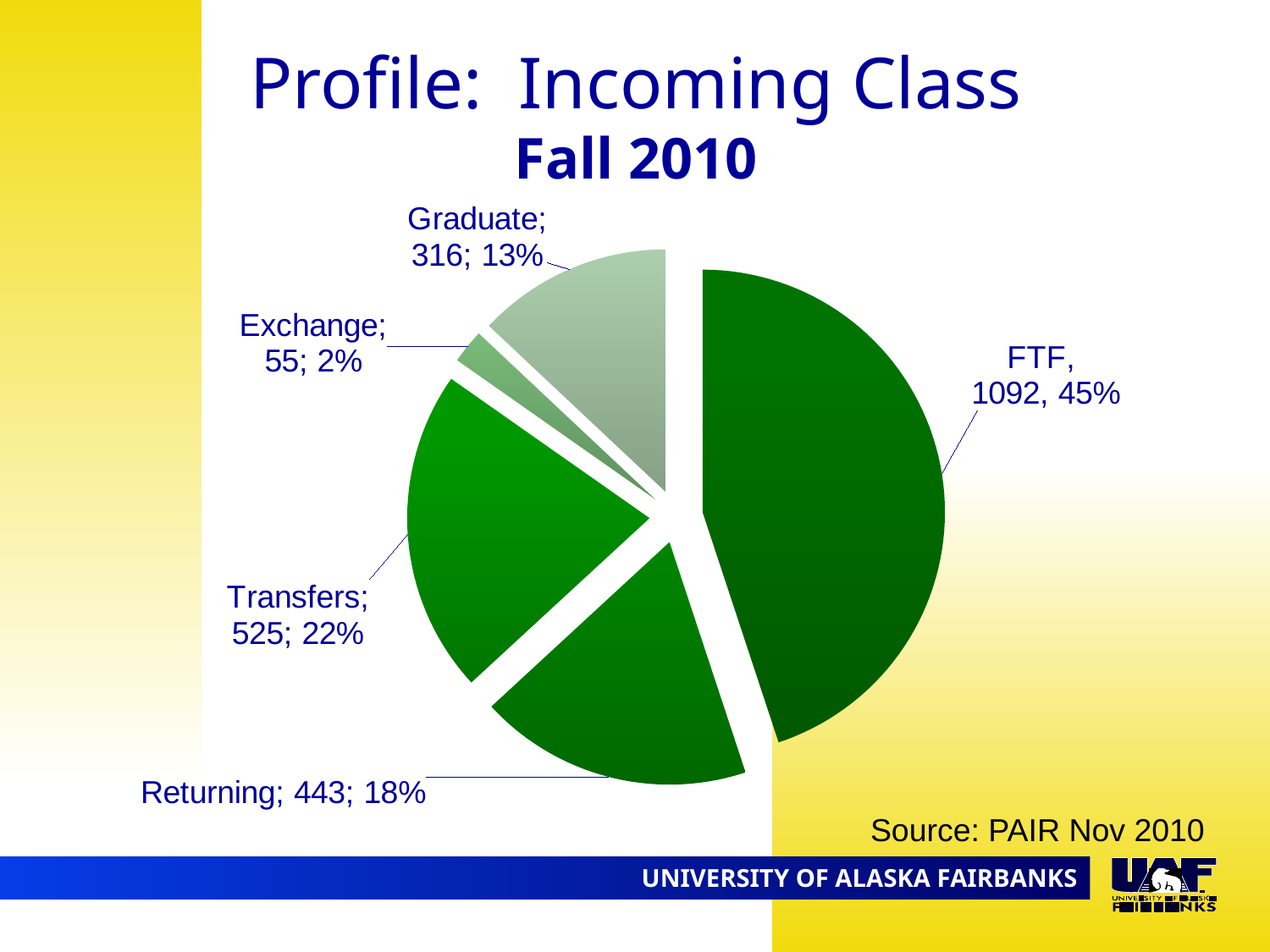
What share of the pie does Returning represent? 18% Which is larger, the value for Transfers or the value for Returning? Transfers Which category has the smallest slice? Exchange What is the value for Exchange? 55 What is the difference between the values for FTF and Transfers? 567 How many slices does the pie chart have? 5 Which category has the largest slice? FTF What is the value for Returning? 443 What share of the pie does Graduate represent? 13% What is the value for Transfers? 525 What is the value for FTF? 1092 What type of chart is shown on the slide? pie chart